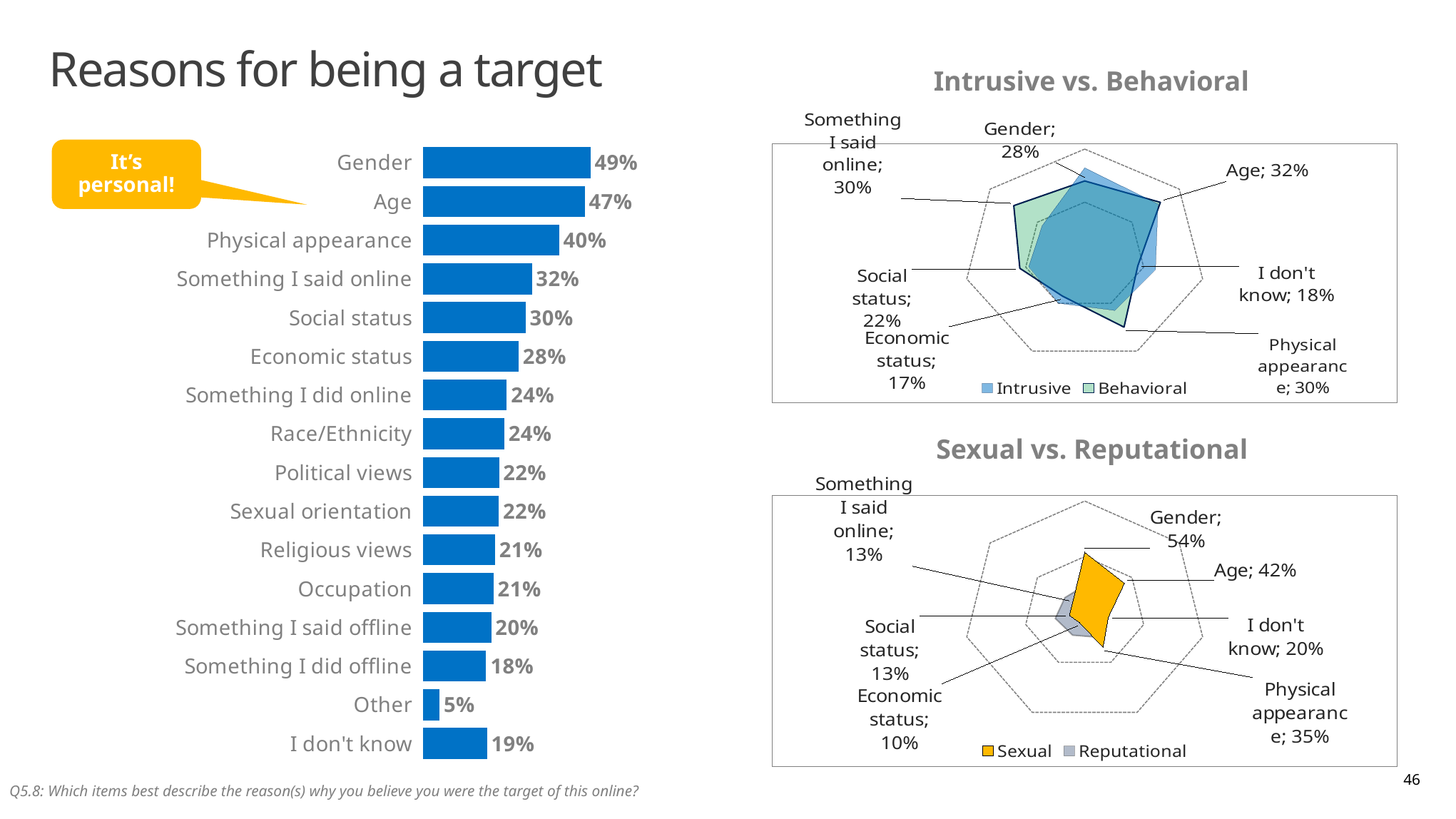
On the bar chart on the left, which category has the highest value? Gender On the bar chart on the left, which category has the lowest value? Other How many series does the legend of the 'Intrusive vs. Behavioral' chart list? 2 On the bar chart on the left, what is the difference between the values for Physical appearance and Social status? 10% On the bar chart on the left, which is larger: the value for Economic status or the value for Race/Ethnicity? Economic status On the bar chart on the left, what percentage is shown for Something I said online? 32% On the bar chart on the left, what percentage is shown for Something I did offline? 18% How many categories are shown on the bar chart on the left? 16 What are the two series named in the legend of the 'Sexual vs. Reputational' chart? Sexual and Reputational On the bar chart on the left, what is the difference between the values for Gender and Age? 2% What kind of chart is the chart on the left of the slide? Bar chart On the bar chart on the left, what percentage is shown for Gender? 49%